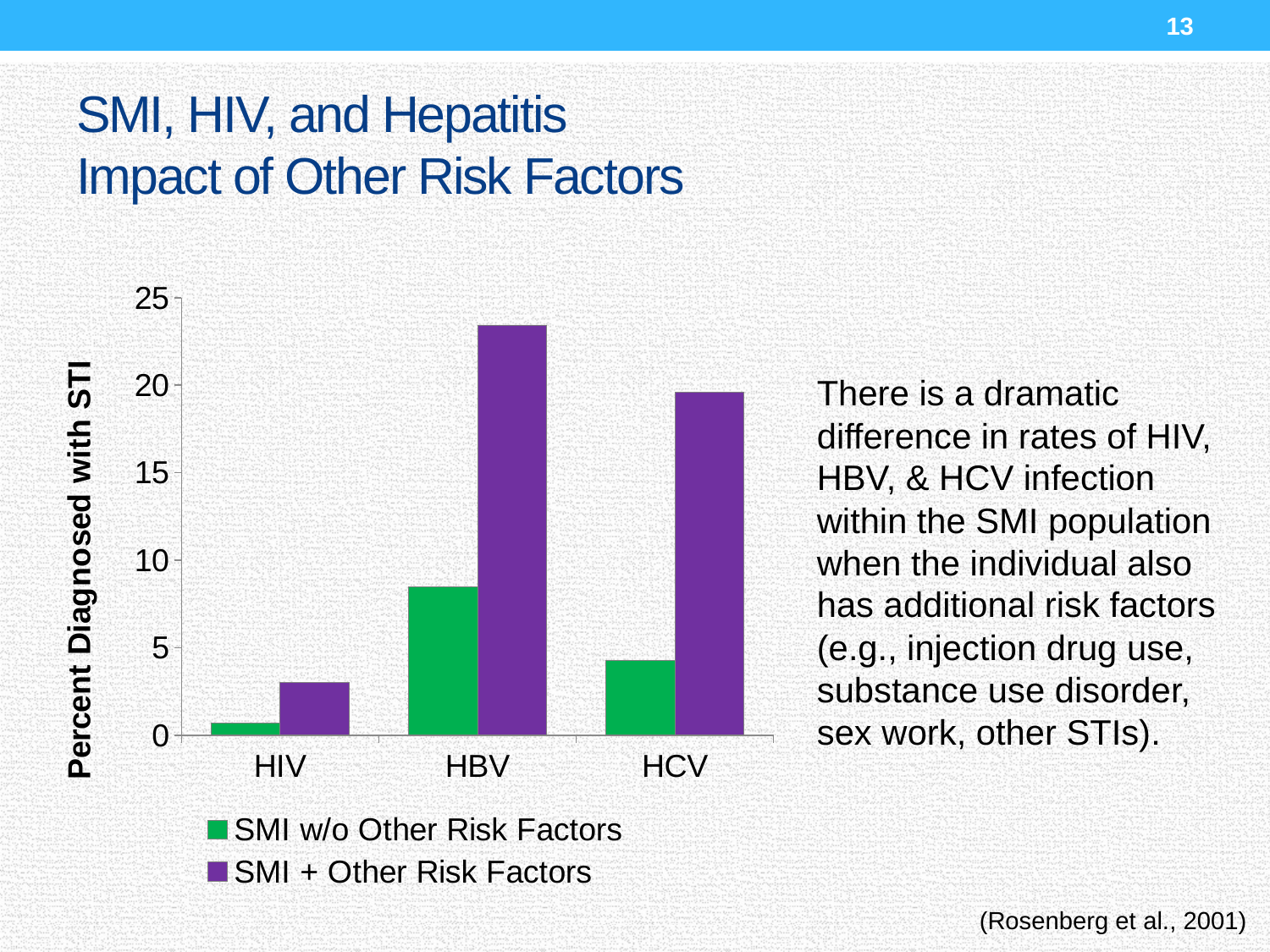
Which category has the highest value for SMI + Other Risk Factors? HBV Is the value for SMI + Other Risk Factors at HIV greater or less than 5? less Is the value for SMI + Other Risk Factors at HCV greater or less than 15? greater How many categories are shown on the x axis of the chart? 3 Is the value for SMI + Other Risk Factors at HBV greater or less than 20? greater What is the label of the chart's y axis? Percent Diagnosed with STI Which category has the lowest value for SMI w/o Other Risk Factors? HIV For HCV, which series has the larger value: SMI w/o Other Risk Factors or SMI + Other Risk Factors? SMI + Other Risk Factors How many series does the chart's legend list? 2 What kind of chart is shown on the slide? bar chart Which category has the lowest value for SMI + Other Risk Factors? HIV